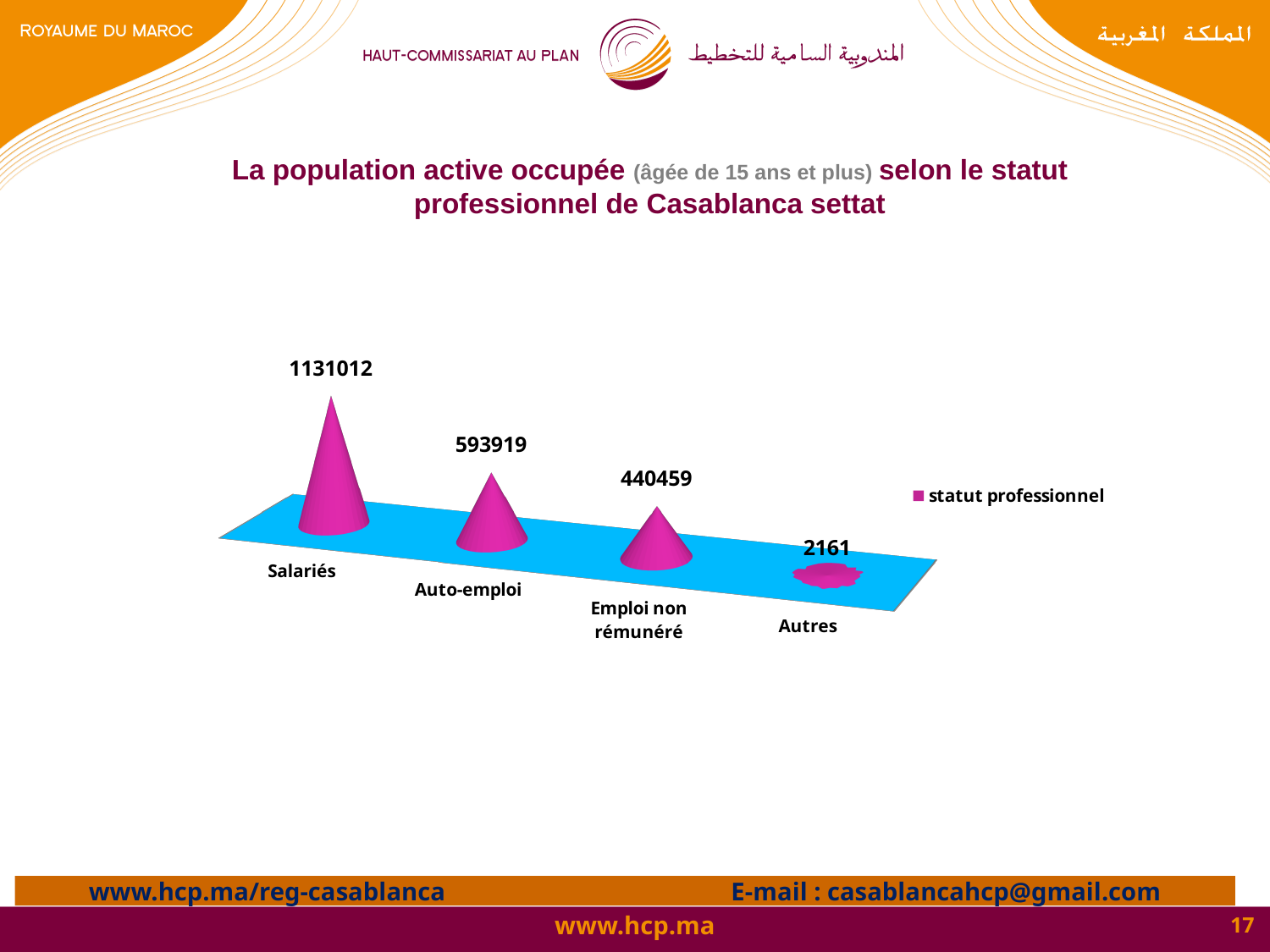
What is the difference between the values for Auto-emploi and Emploi non rémunéré? 153460 What is the name of the series shown in the legend? statut professionnel Which category has the lowest value? Autres What is the difference between the values for Salariés and Auto-emploi? 537093 What is the value for Salariés? 1131012 What is the value for Autres? 2161 What is the value for Auto-emploi? 593919 How many series does the legend list? 1 Which category has the highest value? Salariés What is the value for Emploi non rémunéré? 440459 Which is larger, the value for Emploi non rémunéré or the value for Autres? Emploi non rémunéré How many categories are shown in the chart? 4